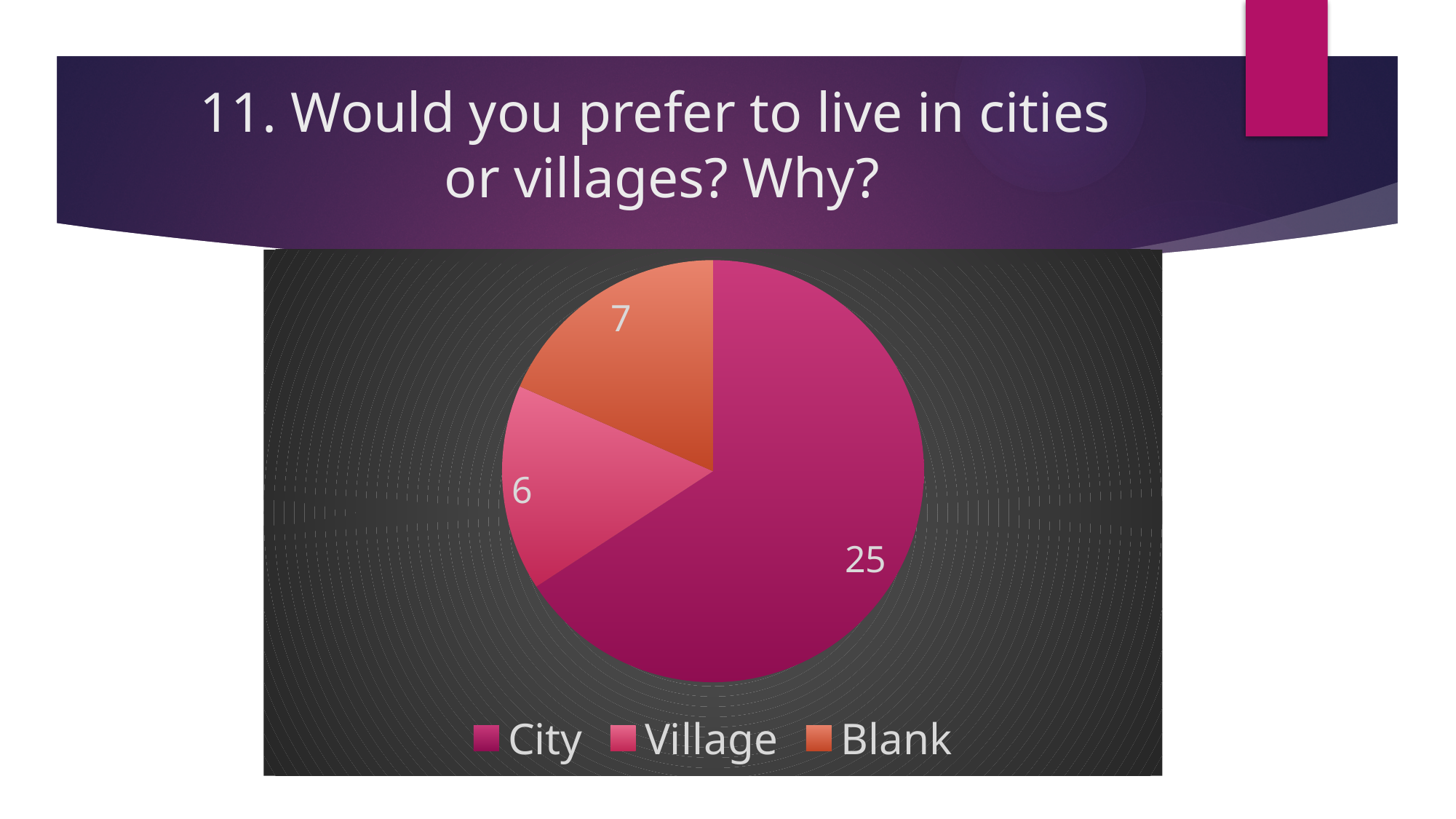
What is the total of all slices in the pie chart? 38 What is the value for Village? 6 Which is larger, the value for Blank or the value for Village? Blank What type of chart is shown on the slide? pie chart What is the title of the slide containing the chart? 11. Would you prefer to live in cities or villages? Why? How many categories does the pie chart have? 3 Which category has the largest slice? City Which category has the smallest slice? Village What is the difference between the Blank value and the Village value? 1 What is the value for Blank? 7 What is the difference between the City value and the Village value? 19 What is the value for City? 25